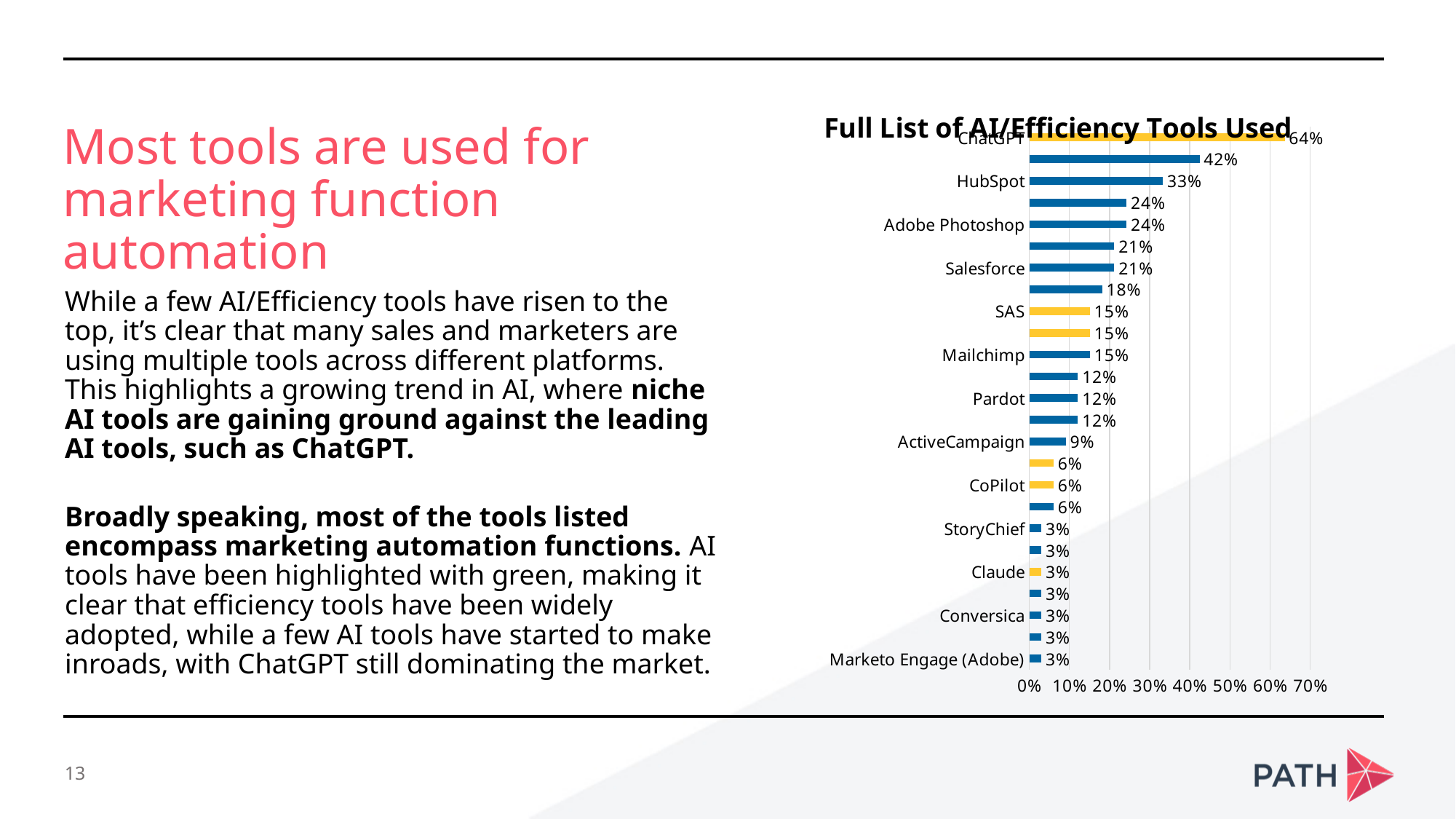
What is the value shown for HubSpot? 33% What is the value shown for Claude? 3% Is the value for HubSpot greater or less than 30%? greater Which has a higher value, Adobe Photoshop or Salesforce? Adobe Photoshop What is the difference in percentage points between ChatGPT and HubSpot? 31 percentage points What percentage of respondents use ChatGPT according to the chart? 64% What is the value shown for ActiveCampaign? 9% Do the bar values increase or decrease going from the top of the chart to the bottom? Decrease What is the title of the chart? Full List of AI/Efficiency Tools Used Which tool has the highest usage in the chart? ChatGPT What kind of chart is shown on the slide? Bar chart What is the value shown for Salesforce? 21%